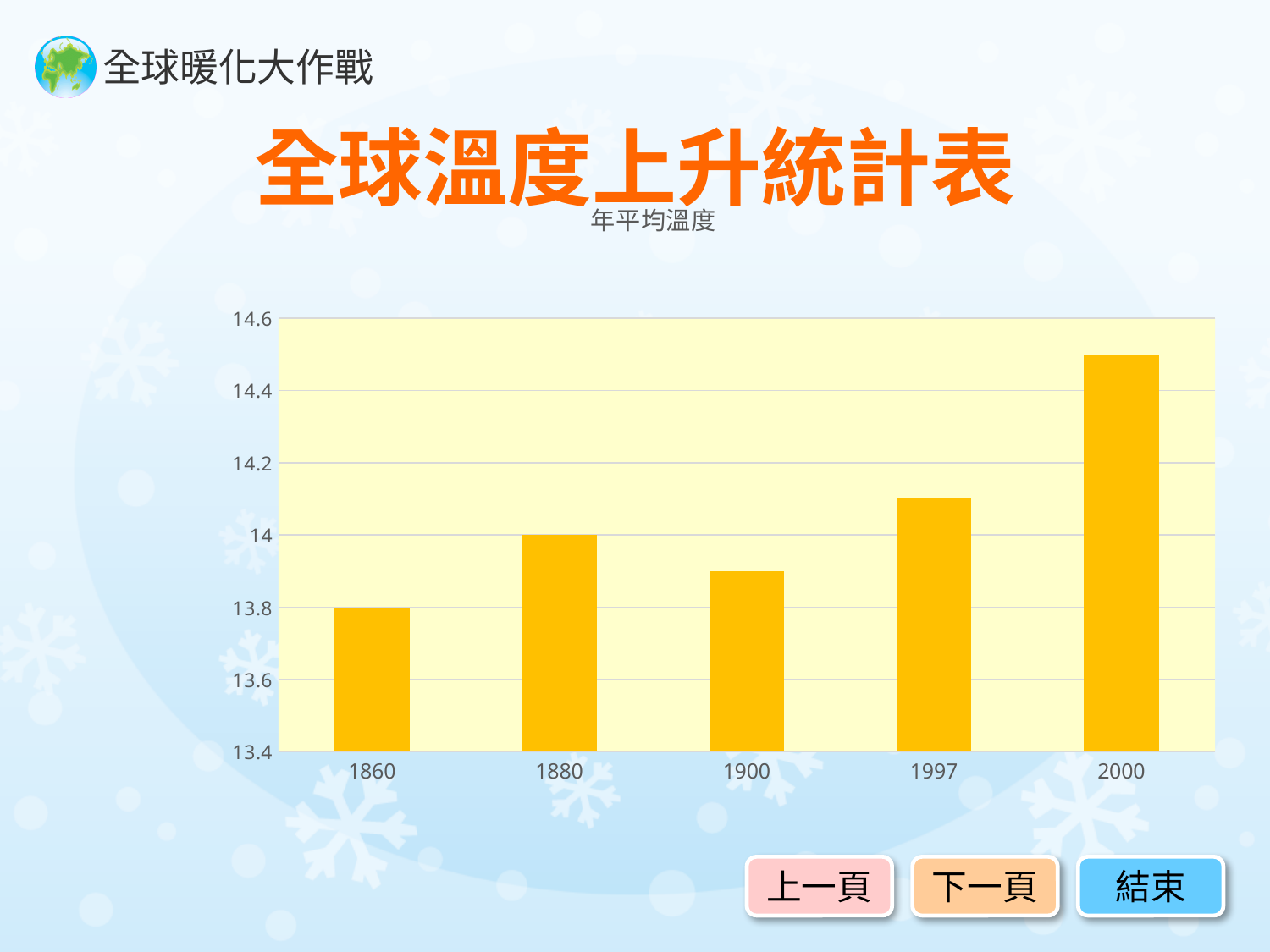
What is the value for 1880? 14 Which year has the lowest value? 1860 Does the value rise or fall from 1997 to 2000? rise How many years (categories) are shown on the x axis? 5 Is the value for 2000 greater or less than 14.4? greater Which is larger, the value for 1880 or the value for 1900? 1880 What is the title of the chart? 年平均溫度 Is the value for 1900 greater or less than 14? less What is the value for 1860? 13.8 What type of chart is shown on the slide? bar chart Which year has the highest value? 2000 What is the difference between the values for 1880 and 1860? 0.2